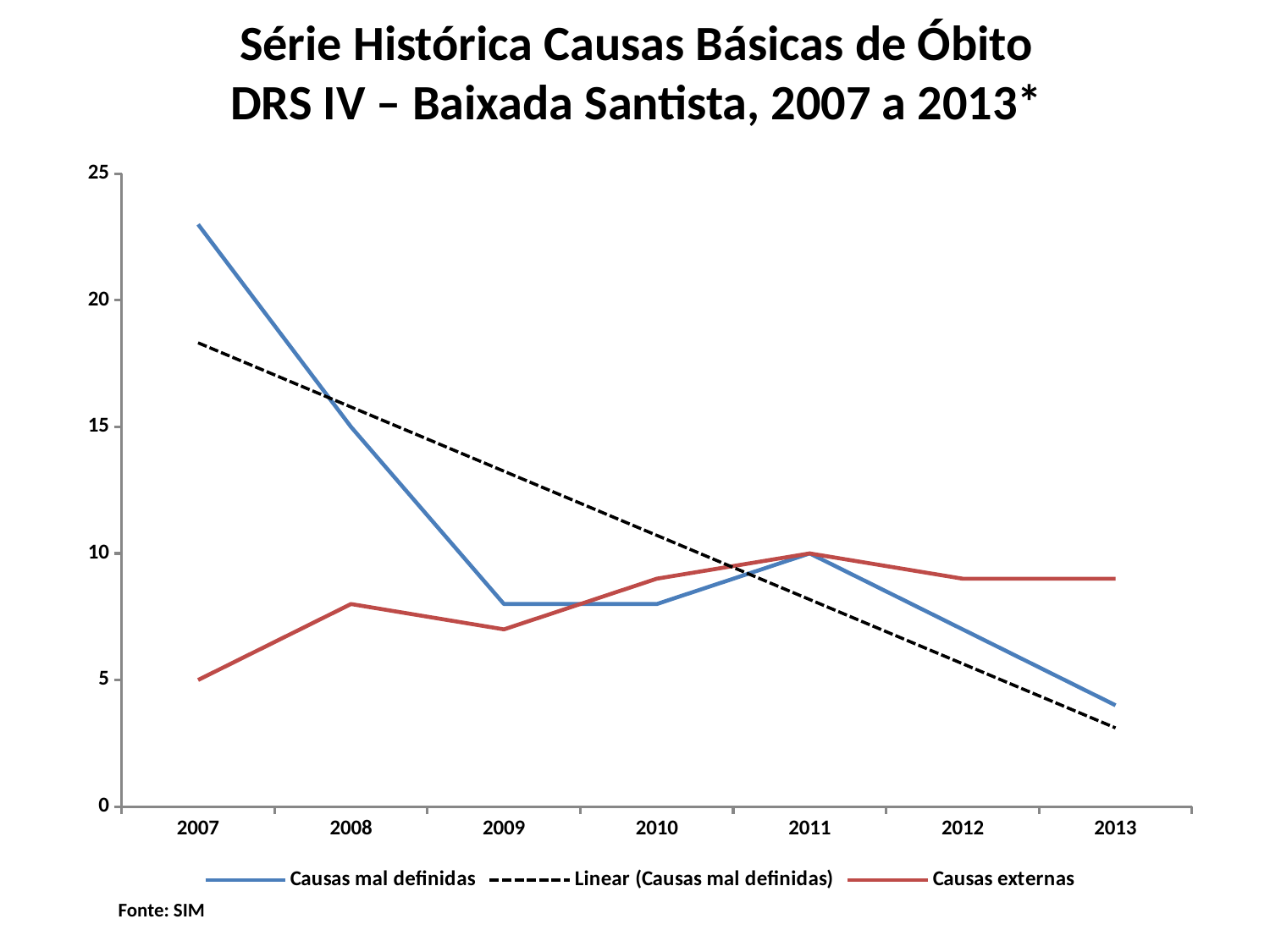
In which year is the value for Causas externas lowest? 2007 In which year is the value for Causas mal definidas lowest? 2013 What kind of chart is shown on the slide? line chart How many years are shown on the x axis? 7 What is the value for Causas externas in 2011? 10 Does the value for Causas mal definidas rise or fall from 2007 to 2013? fall Which series has the larger value in 2013, Causas mal definidas or Causas externas? Causas externas What is the value for Causas externas in 2007? 5 How many series does the legend list? 3 In which year is the value for Causas mal definidas highest? 2007 Is the value for Causas mal definidas in 2007 greater or less than 20? greater In which year is the value for Causas externas highest? 2011